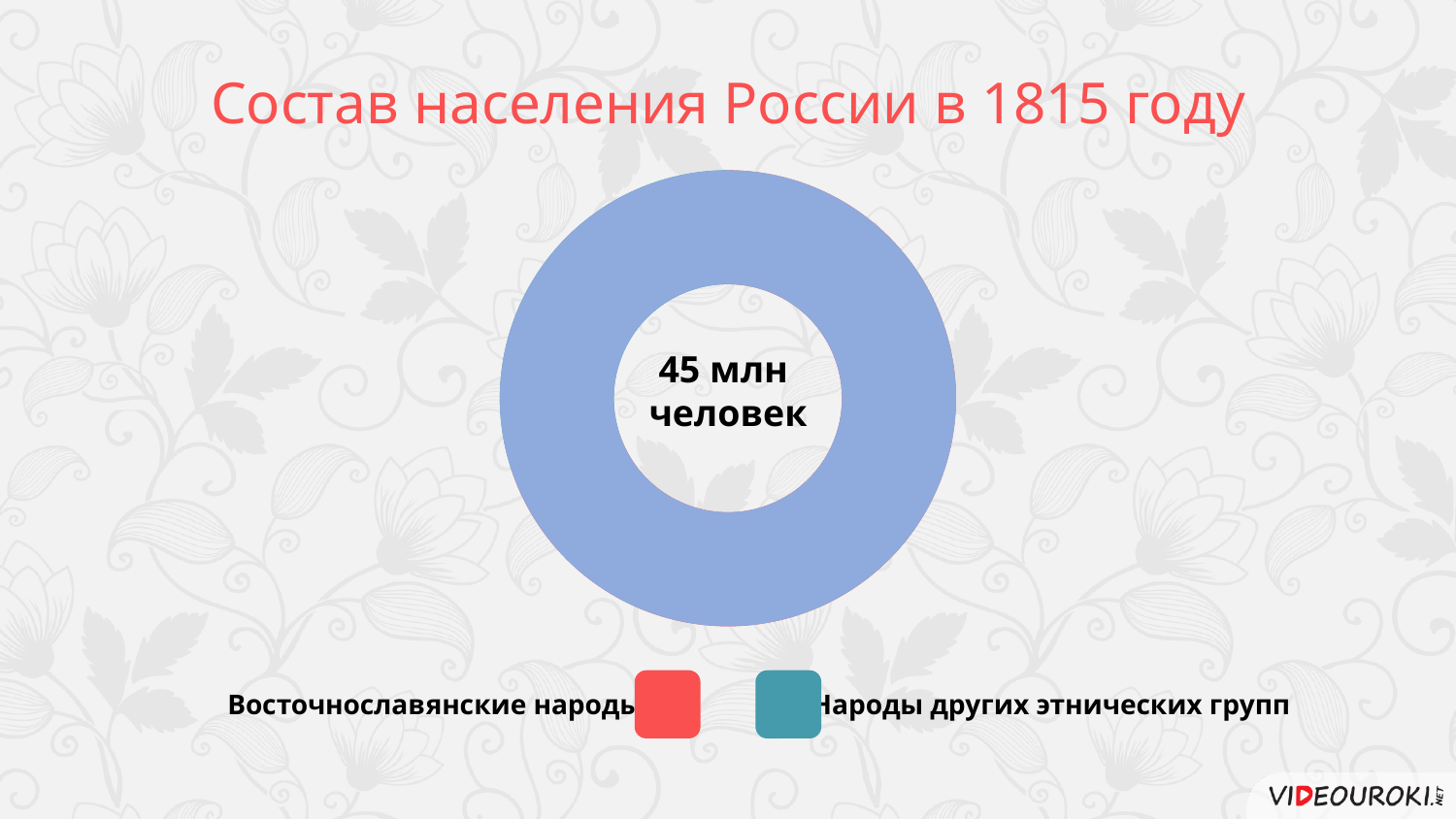
What total value is printed in the centre of the donut chart? 45 млн человек What is the title of the chart on the slide? Состав населения России в 1815 году How many entries does the chart's legend list? 2 Which legend entry is shown in red? Восточнославянские народы What kind of chart is shown on the slide? Pie (donut) chart